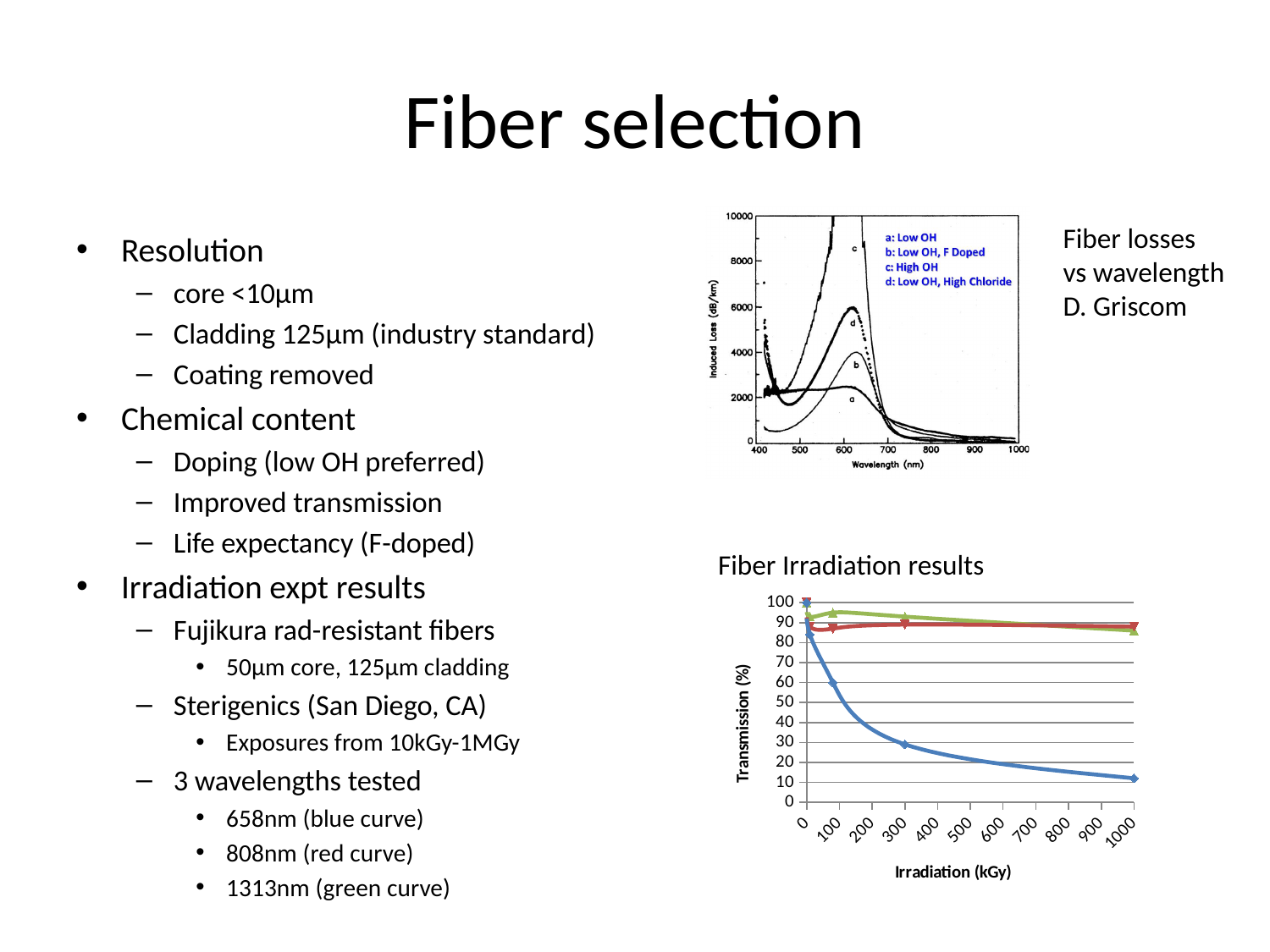
In the 'Fiber Irradiation results' chart, does the blue (658nm) curve rise or fall as irradiation increases? fall What type of chart is the 'Fiber Irradiation results' chart? line chart In the 'Fiber Irradiation results' chart, which curve has the lowest transmission at 1000 kGy? blue (658nm) How many curves (wavelengths) are plotted in the 'Fiber Irradiation results' chart? 3 In the 'Fiber Irradiation results' chart, is the transmission of the blue (658nm) curve at 1000 kGy greater or less than 20? less In the 'Fiber losses vs wavelength' chart, how many fiber types are listed in the legend? 4 In the 'Fiber Irradiation results' chart, at 1000 kGy, which has higher transmission: the blue (658nm) curve or the red (808nm) curve? red (808nm) In the 'Fiber Irradiation results' chart, what is the label of the y axis? Transmission (%) In the 'Fiber Irradiation results' chart, what is the label of the x axis? Irradiation (kGy) In the 'Fiber Irradiation results' chart, is the transmission of the blue (658nm) curve at 300 kGy greater or less than 40? less In the 'Fiber Irradiation results' chart, is the transmission of the red (808nm) curve at 1000 kGy greater or less than 80? greater In the 'Fiber losses vs wavelength' chart, which fiber type reaches the highest induced loss? c: High OH